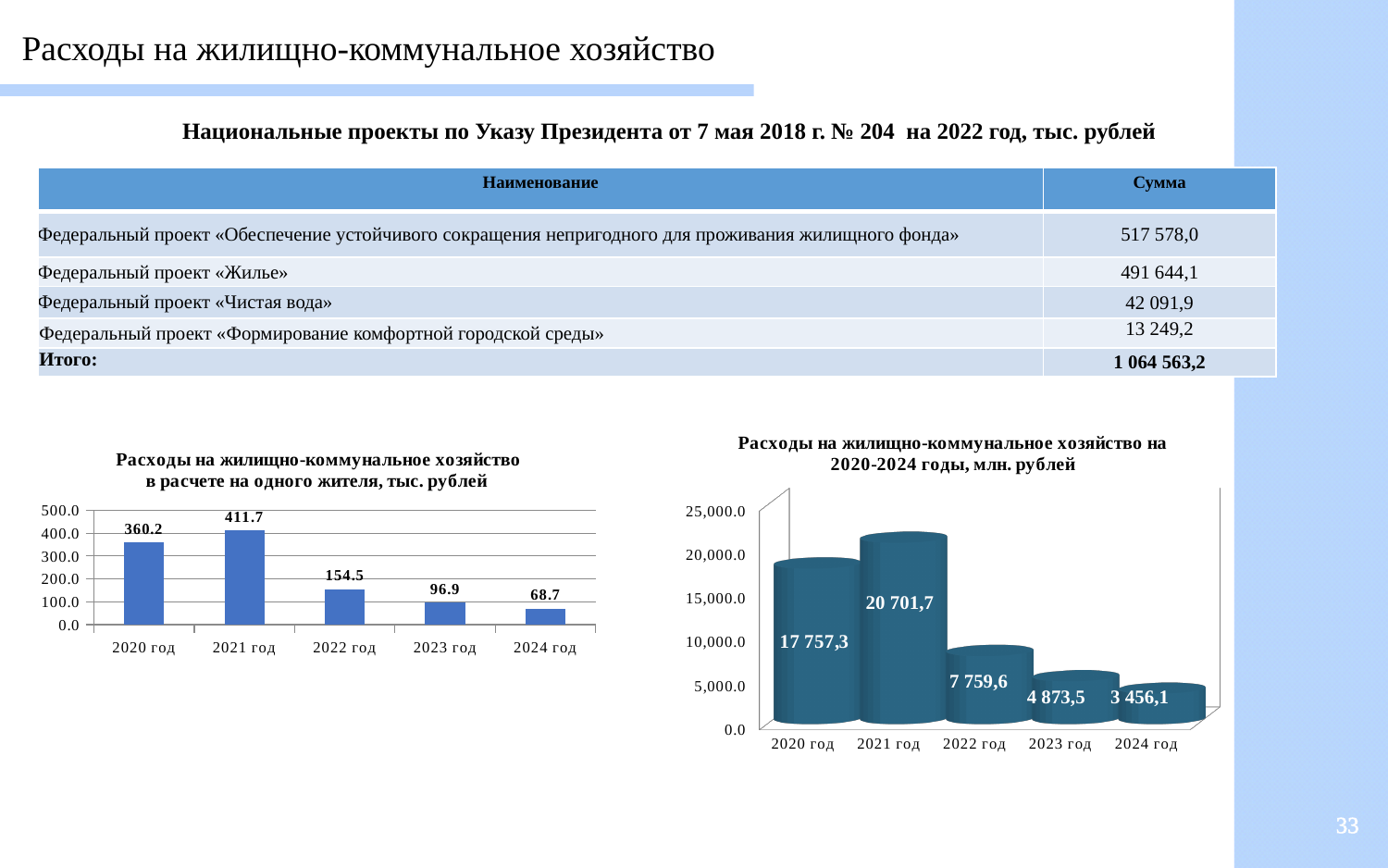
На диаграмме «Расходы на жилищно-коммунальное хозяйство на 2020-2024 годы, млн. рублей» какой год имеет наибольшее значение? 2021 год На диаграмме «Расходы на жилищно-коммунальное хозяйство на 2020-2024 годы, млн. рублей» какое значение больше: 2020 года или 2023 года? 2020 года На диаграмме «Расходы на жилищно-коммунальное хозяйство на 2020-2024 годы, млн. рублей» какое значение указано для 2022 года? 7 759,6 На диаграмме «Расходы на жилищно-коммунальное хозяйство в расчете на одного жителя, тыс. рублей» сколько лет (категорий) показано? 5 На диаграмме «Расходы на жилищно-коммунальное хозяйство в расчете на одного жителя, тыс. рублей» какое значение указано для 2021 года? 411.7 На диаграмме «Расходы на жилищно-коммунальное хозяйство в расчете на одного жителя, тыс. рублей» значения растут или падают с 2021 по 2024 год? падают На диаграмме «Расходы на жилищно-коммунальное хозяйство в расчете на одного жителя, тыс. рублей» какой год имеет наименьшее значение? 2024 год На диаграмме «Расходы на жилищно-коммунальное хозяйство в расчете на одного жителя, тыс. рублей» какой год имеет наибольшее значение? 2021 год На диаграмме «Расходы на жилищно-коммунальное хозяйство на 2020-2024 годы, млн. рублей» на сколько значение 2021 года больше значения 2020 года? 2 944,4 На диаграмме «Расходы на жилищно-коммунальное хозяйство на 2020-2024 годы, млн. рублей» какое значение указано для 2024 года? 3 456,1 На диаграмме «Расходы на жилищно-коммунальное хозяйство в расчете на одного жителя, тыс. рублей» на сколько значение 2020 года больше значения 2022 года? 205.7 Какого типа диаграмма «Расходы на жилищно-коммунальное хозяйство на 2020-2024 годы, млн. рублей»? столбчатая (bar chart)